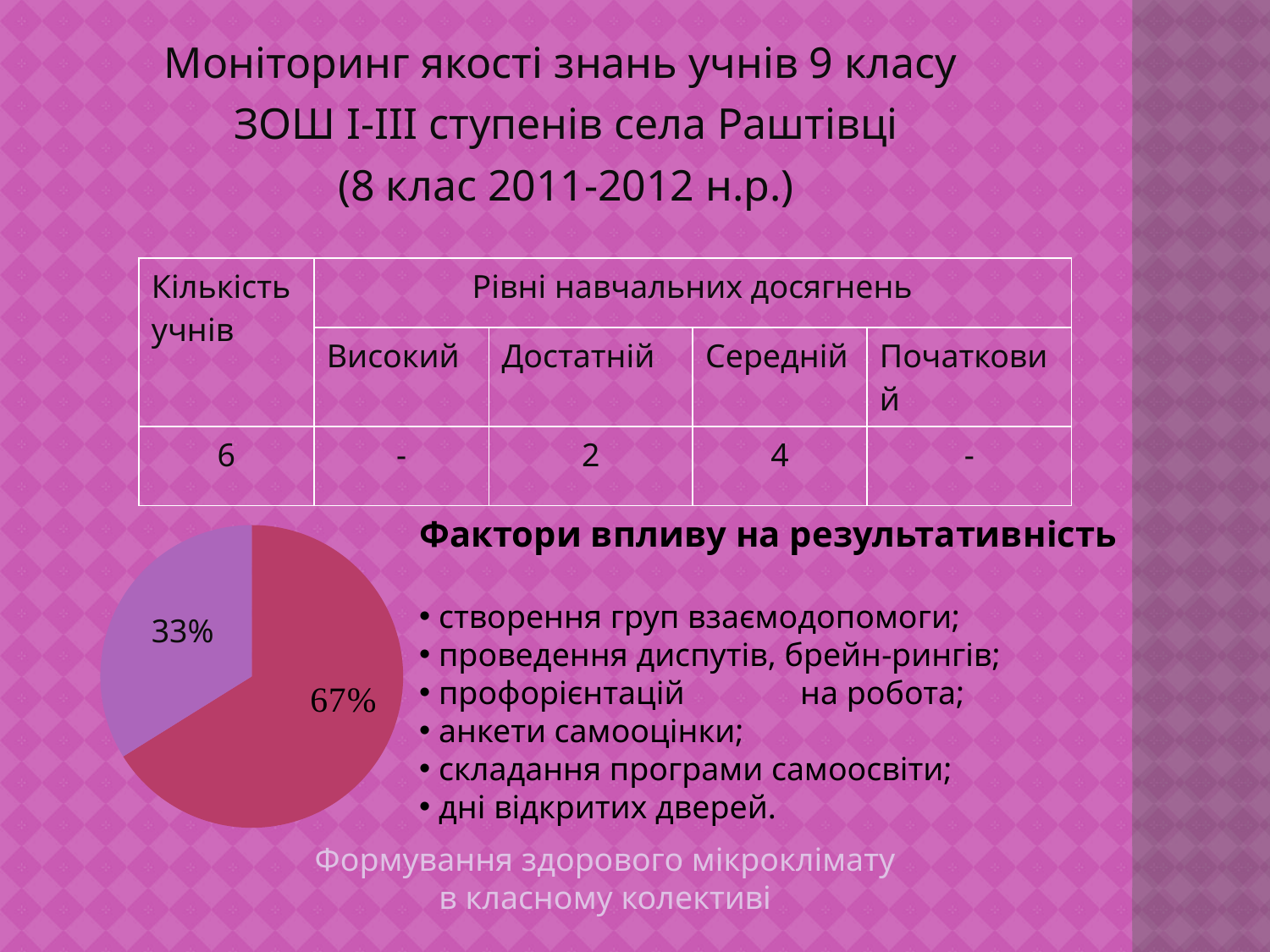
Does the pie chart have a legend? No What is the value of the smallest slice of the pie chart? 33% What is the value shown on the purple slice of the pie chart? 33% By how many percentage points does the larger slice of the pie chart exceed the smaller slice? 34 percentage points How many slices does the pie chart have? 2 What is the value shown on the red slice of the pie chart? 67% What do the two slice values of the pie chart add up to? 100% What kind of chart is shown on the slide? pie chart What is the value of the largest slice of the pie chart? 67% Which slice of the pie chart is larger, the red one or the purple one? the red one